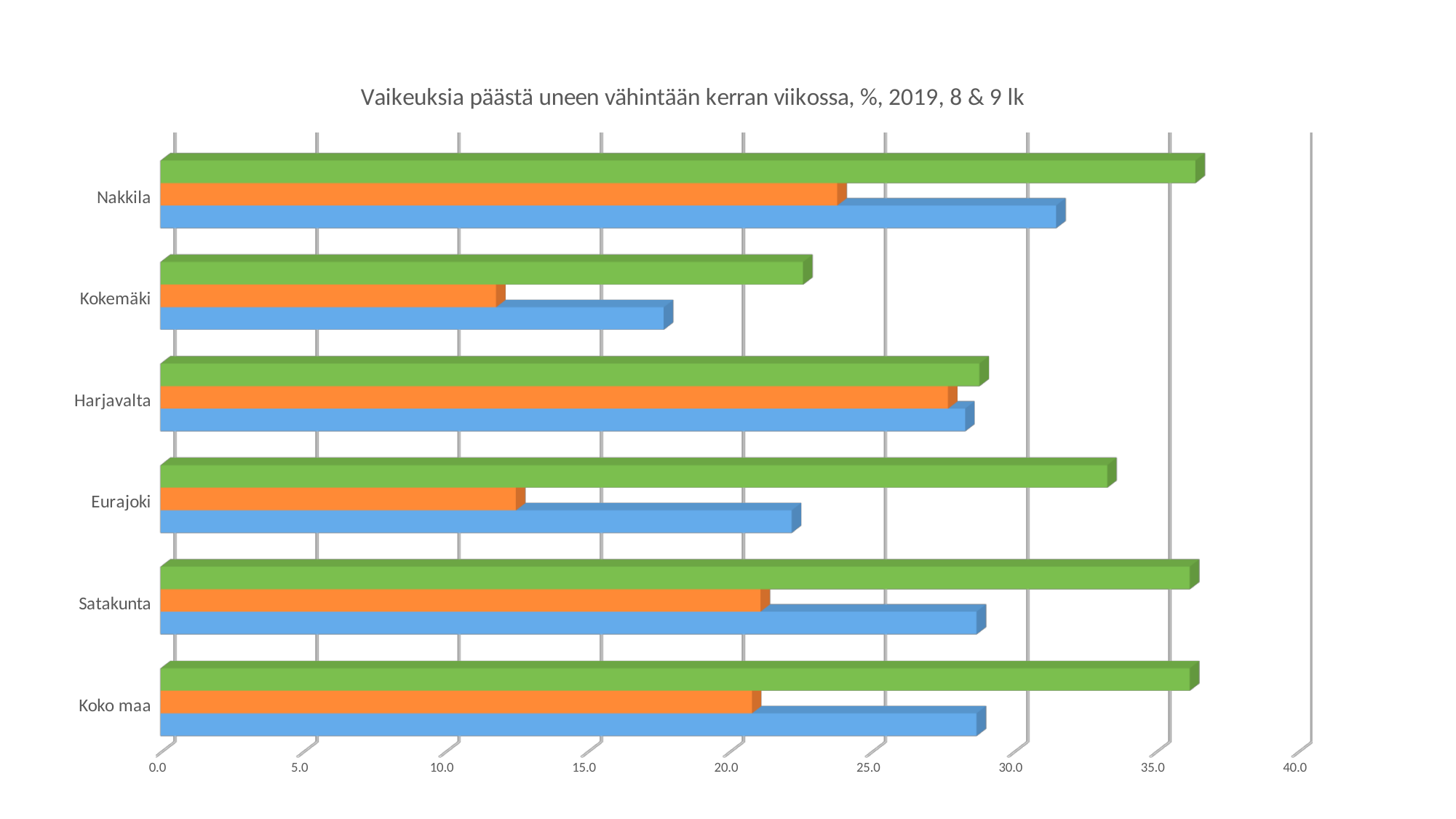
Is the blue bar for Eurajoki greater or less than 20.0? greater Which category has the highest blue bar? Nakkila Which category has the lowest green bar? Kokemäki How many categories are shown on the vertical axis of the chart? 6 Which category has the lowest blue bar? Kokemäki What is the title of the chart? Vaikeuksia päästä uneen vähintään kerran viikossa, %, 2019, 8 & 9 lk What kind of chart is shown on the slide? bar chart Which is larger, the green bar for Eurajoki or the green bar for Harjavalta? Eurajoki Which category has the highest orange bar? Harjavalta Is the green bar for Nakkila greater or less than 35.0? greater Is the orange bar for Kokemäki greater or less than 15.0? less What is the highest value shown on the horizontal axis of the chart? 40.0